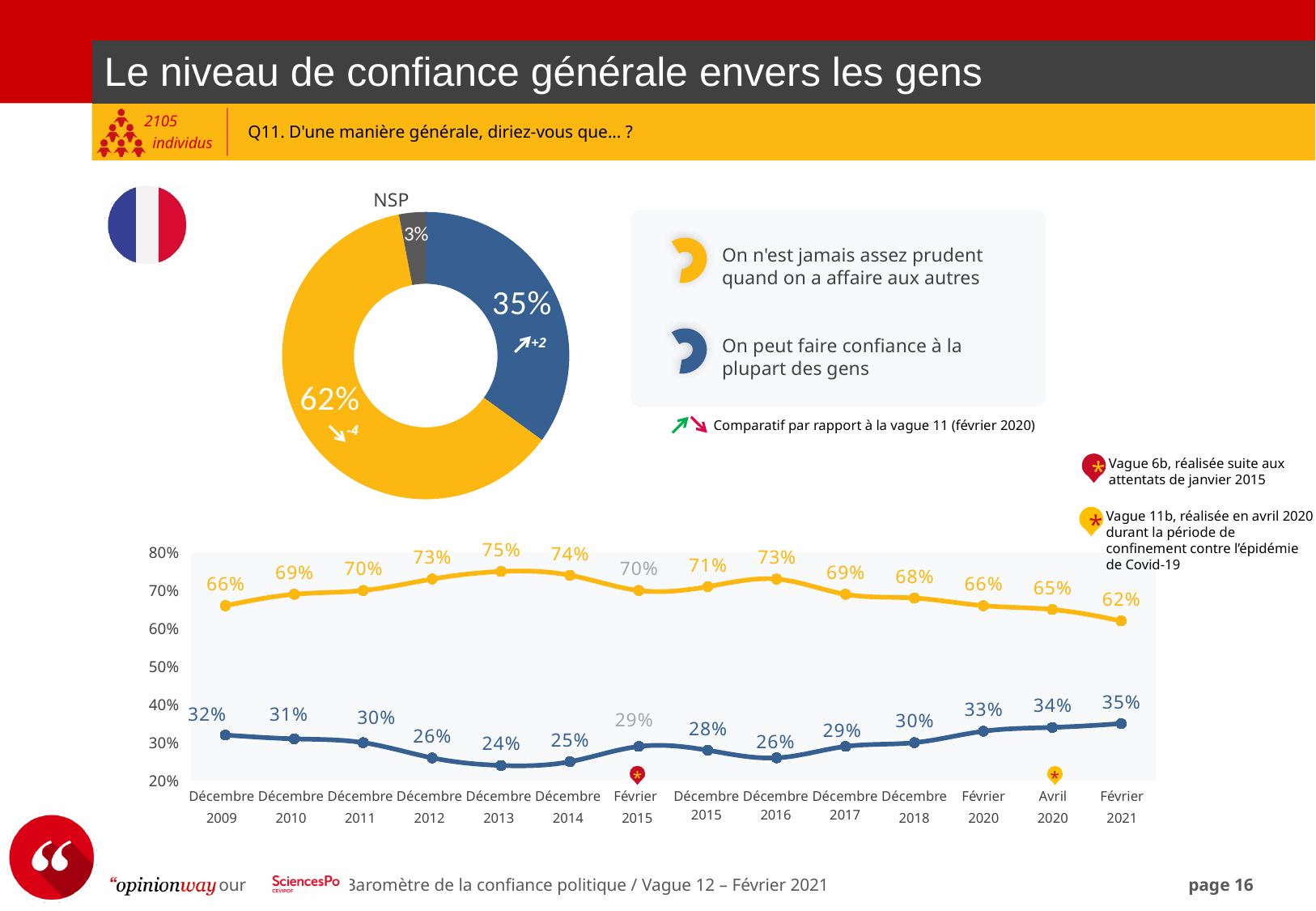
In the line chart at the bottom, at which date does the blue series reach its lowest value? Décembre 2013 In the line chart at the bottom, what is the difference between the yellow series and the blue series in Février 2021? 27 points In the line chart at the bottom, does the blue series rise or fall between Décembre 2016 and Février 2021? Rises In the donut chart, what percentage is shown for NSP? 3% In the donut chart, what percentage is shown for "On peut faire confiance à la plupart des gens"? 35% In the donut chart, what is the difference between the share for "On n'est jamais assez prudent quand on a affaire aux autres" and the share for "On peut faire confiance à la plupart des gens"? 27 points In the line chart at the bottom, what is the value of the blue series ("On peut faire confiance à la plupart des gens") for Décembre 2013? 24% In the donut chart, which response has the largest share? On n'est jamais assez prudent quand on a affaire aux autres In the line chart at the bottom, at which date does the yellow series reach its highest value? Décembre 2013 How many time points are plotted in the line chart at the bottom? 14 In the line chart at the bottom, what is the value of the yellow series ("On n'est jamais assez prudent") for Décembre 2013? 75% What kind of chart is the chart at the bottom of the slide? Line chart